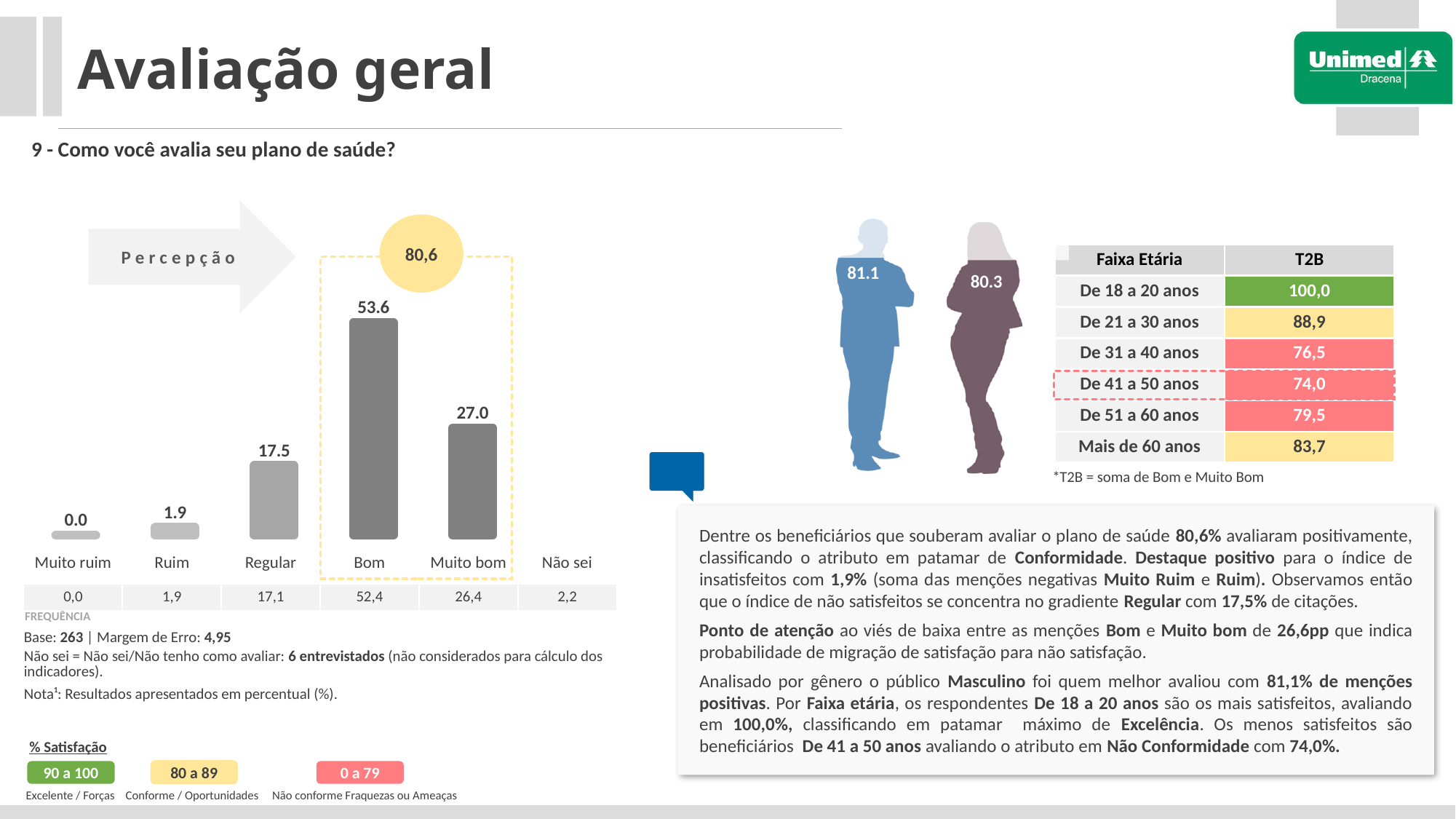
What type of chart is used to show the evaluation of the health plan? Bar chart Which is larger in the bar chart, the value for Regular or the value for Muito bom? Muito bom What is the difference between the values for Regular and Ruim in the bar chart? 15.6 What is the value shown for the Bom category in the bar chart? 53.6 What is the value shown for the Muito ruim category in the bar chart? 0.0 What is the value shown for the Ruim category in the bar chart? 1.9 Which category has the highest value in the bar chart? Bom Which category has the lowest value in the bar chart? Muito ruim What is the value shown for the Muito bom category in the bar chart? 27.0 What value is shown in the yellow circle above the dashed box around Bom and Muito bom? 80,6 What is the value shown for the Regular category in the bar chart? 17.5 What is the difference between the values for Bom and Muito bom in the bar chart? 26.6